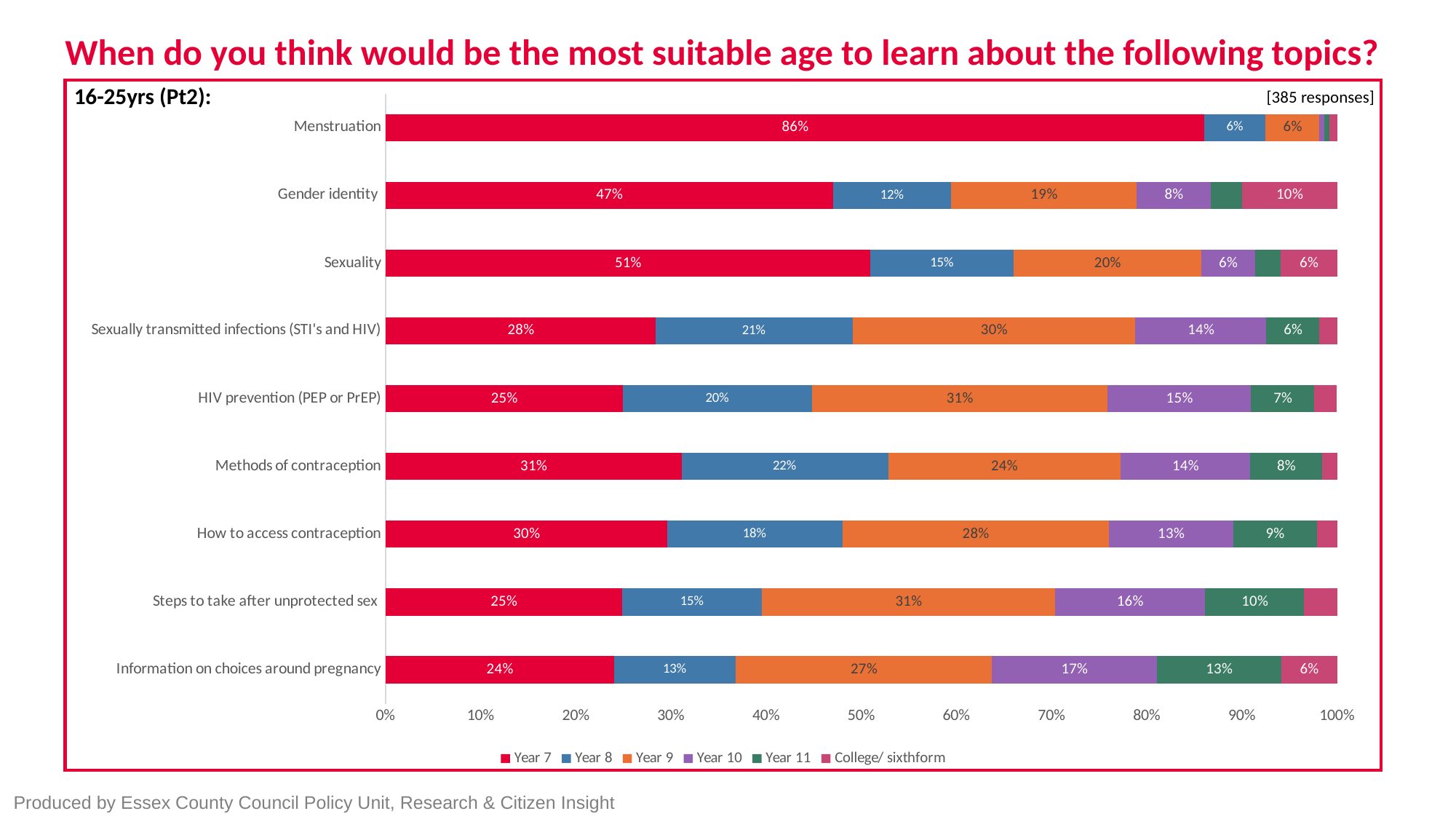
How many responses does the chart say it is based on? 385 responses How many topics are shown on the chart? 9 What percentage chose Year 9 for HIV prevention (PEP or PrEP)? 31% What type of chart is shown on the slide? Stacked bar chart How many series does the legend list? 6 Which topic has the highest Year 7 percentage? Menstruation Which is larger: the Year 9 value for Sexually transmitted infections (STI's and HIV) or the Year 9 value for Methods of contraception? Sexually transmitted infections (STI's and HIV) What is the Year 10 value for Information on choices around pregnancy? 17% Which topic has the lowest Year 7 percentage? Information on choices around pregnancy What percentage of respondents chose Year 7 as the most suitable age to learn about Menstruation? 86% What is the difference in percentage points between the Year 7 value for Menstruation and the Year 7 value for Gender identity? 39 percentage points What is the Year 8 value for Methods of contraception? 22%